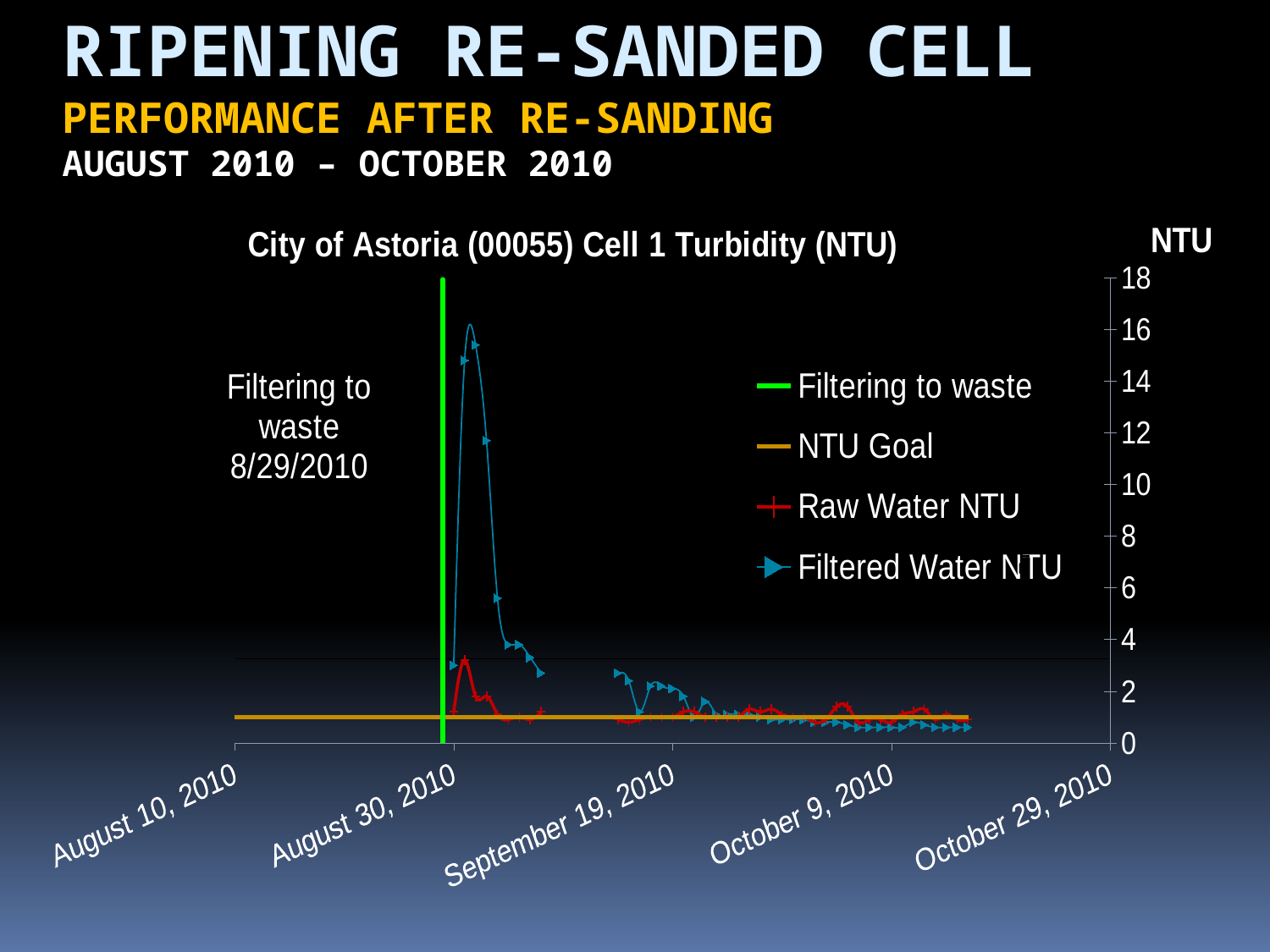
On what date does the annotation say filtering to waste occurred? 8/29/2010 What is the title of the chart? City of Astoria (00055) Cell 1 Turbidity (NTU) Is the peak value of the Filtered Water NTU series greater or less than 14? greater Is the peak value of the Raw Water NTU series greater or less than 4? less What is the highest value shown on the vertical axis? 18 Is the NTU Goal line greater or less than 2? less Which series reaches the highest value on the chart? Filtered Water NTU How many series does the legend list? 4 What kind of chart is shown on the slide? line chart After its peak in early September, does the Filtered Water NTU series rise or fall toward the end of October? fall Which of the two series, Filtered Water NTU or Raw Water NTU, has the larger peak value? Filtered Water NTU